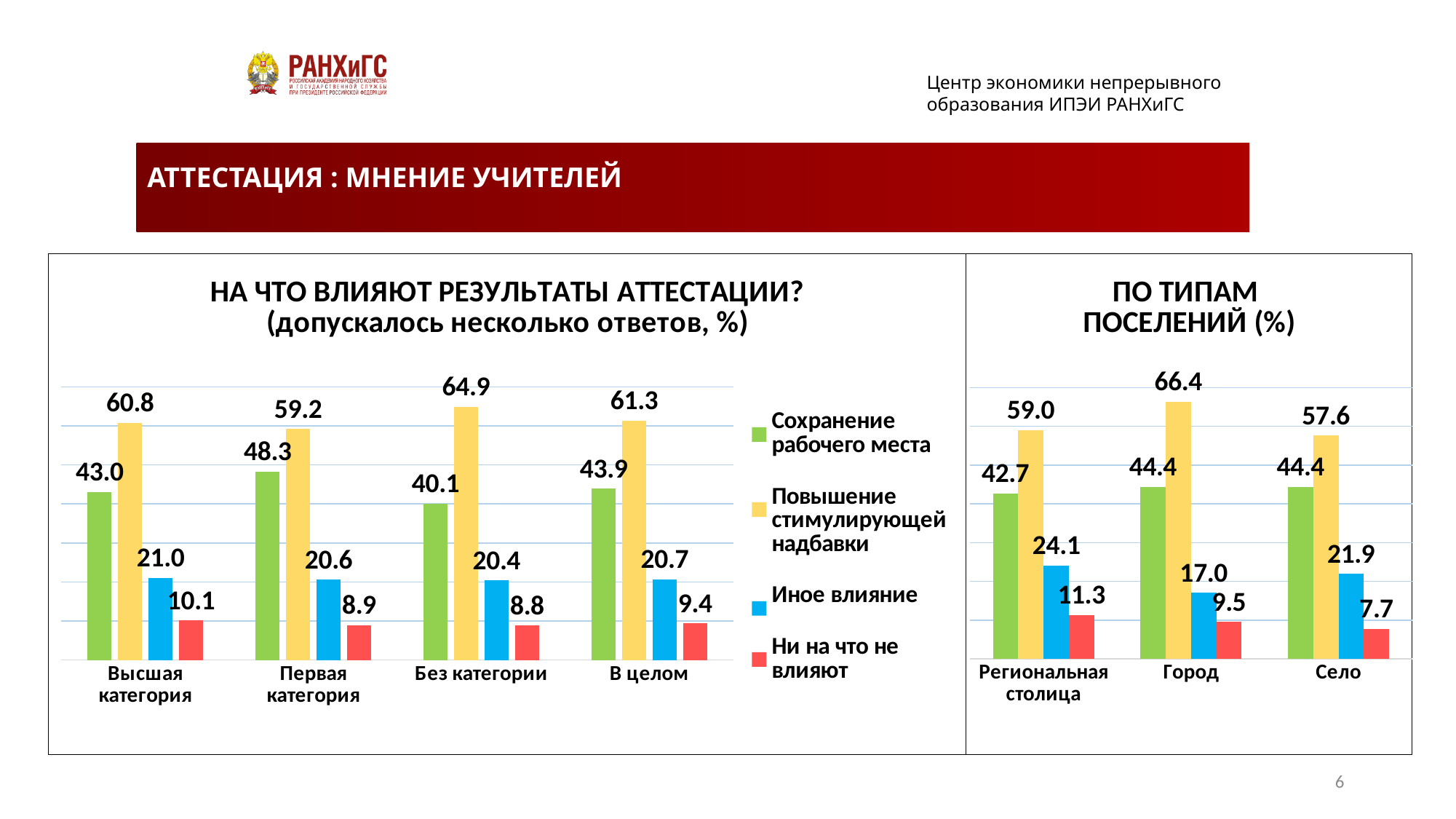
In the chart 'ПО ТИПАМ ПОСЕЛЕНИЙ (%)', which settlement type has the highest value for 'Повышение стимулирующей надбавки'? Город In the chart 'ПО ТИПАМ ПОСЕЛЕНИЙ (%)', what is the value of 'Иное влияние' for 'Региональная столица'? 24.1 In the chart 'НА ЧТО ВЛИЯЮТ РЕЗУЛЬТАТЫ АТТЕСТАЦИИ?', how many categories are shown on the x axis? 4 In the chart 'НА ЧТО ВЛИЯЮТ РЕЗУЛЬТАТЫ АТТЕСТАЦИИ?', what is the value of 'Сохранение рабочего места' for 'Первая категория'? 48.3 How many series does the legend list? 4 In the chart 'ПО ТИПАМ ПОСЕЛЕНИЙ (%)', which is larger: 'Иное влияние' for 'Город' or for 'Село'? Село What type of chart is 'ПО ТИПАМ ПОСЕЛЕНИЙ (%)'? Bar chart In the chart 'НА ЧТО ВЛИЯЮТ РЕЗУЛЬТАТЫ АТТЕСТАЦИИ?', which category has the highest value for 'Повышение стимулирующей надбавки'? Без категории In the chart 'НА ЧТО ВЛИЯЮТ РЕЗУЛЬТАТЫ АТТЕСТАЦИИ?', which category has the lowest value for 'Ни на что не влияют'? Без категории In the chart 'ПО ТИПАМ ПОСЕЛЕНИЙ (%)', what is the difference between 'Ни на что не влияют' for 'Региональная столица' and 'Село'? 3.6 In the chart 'НА ЧТО ВЛИЯЮТ РЕЗУЛЬТАТЫ АТТЕСТАЦИИ?', what is the difference between 'Повышение стимулирующей надбавки' and 'Сохранение рабочего места' for 'В целом'? 17.4 In the chart 'НА ЧТО ВЛИЯЮТ РЕЗУЛЬТАТЫ АТТЕСТАЦИИ?', what is the value of 'Повышение стимулирующей надбавки' for 'Без категории'? 64.9